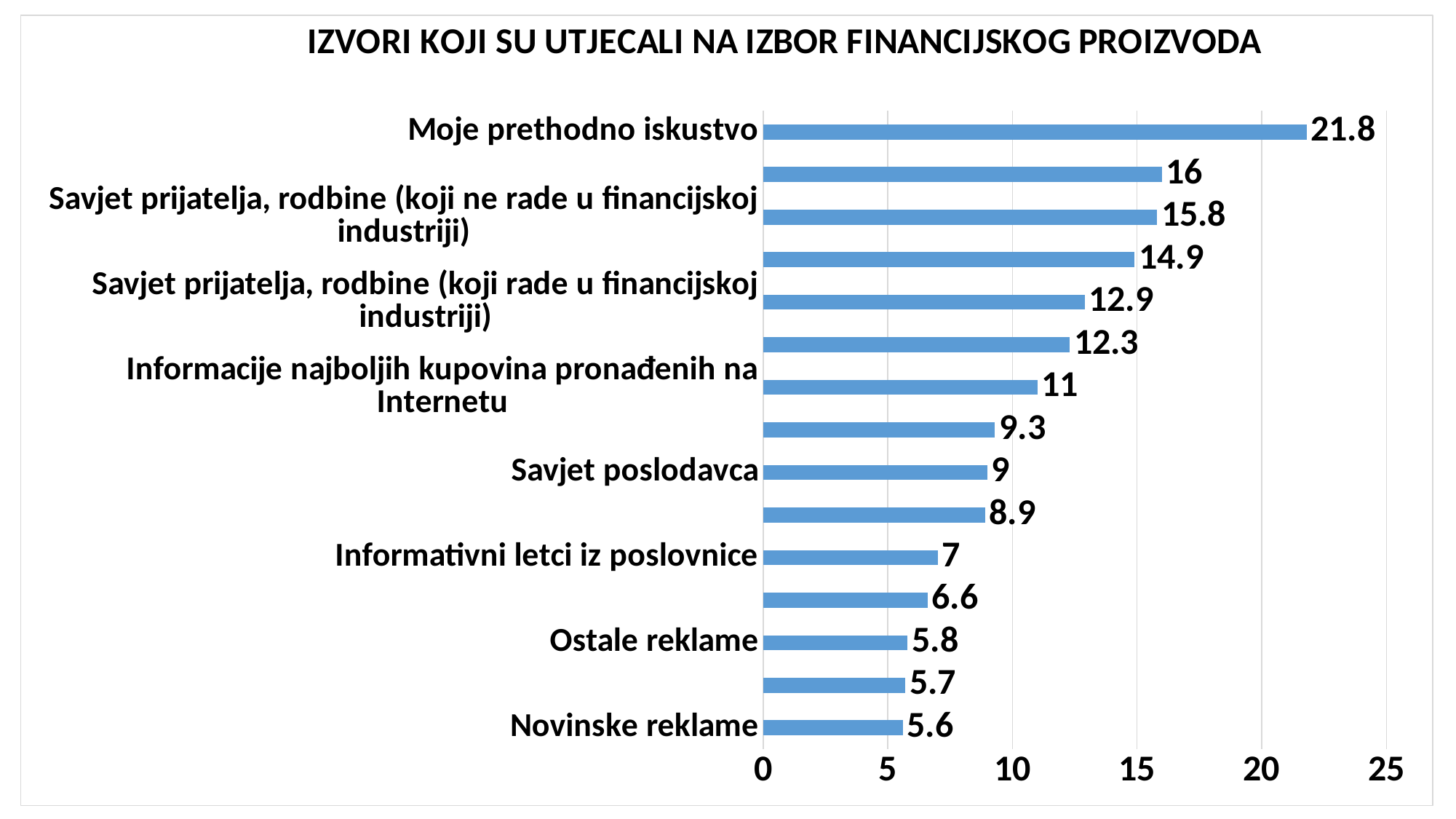
What is the value for "Informacije najboljih kupovina pronađenih na Internetu"? 11 What is the value for "Novinske reklame"? 5.6 What kind of chart is shown on the slide? Bar chart How many bars are plotted in the chart? 15 Is the value for "Ostale reklame" greater or less than 10? less What is the value for "Informativni letci iz poslovnice"? 7 Which category has the lowest value? Novinske reklame Which category has the highest value? Moje prethodno iskustvo Which is larger, the value for "Savjet poslodavca" or the value for "Informativni letci iz poslovnice"? Savjet poslodavca What is the value for "Savjet poslodavca"? 9 What is the value for "Moje prethodno iskustvo"? 21.8 What is the difference between the values for "Moje prethodno iskustvo" and "Novinske reklame"? 16.2